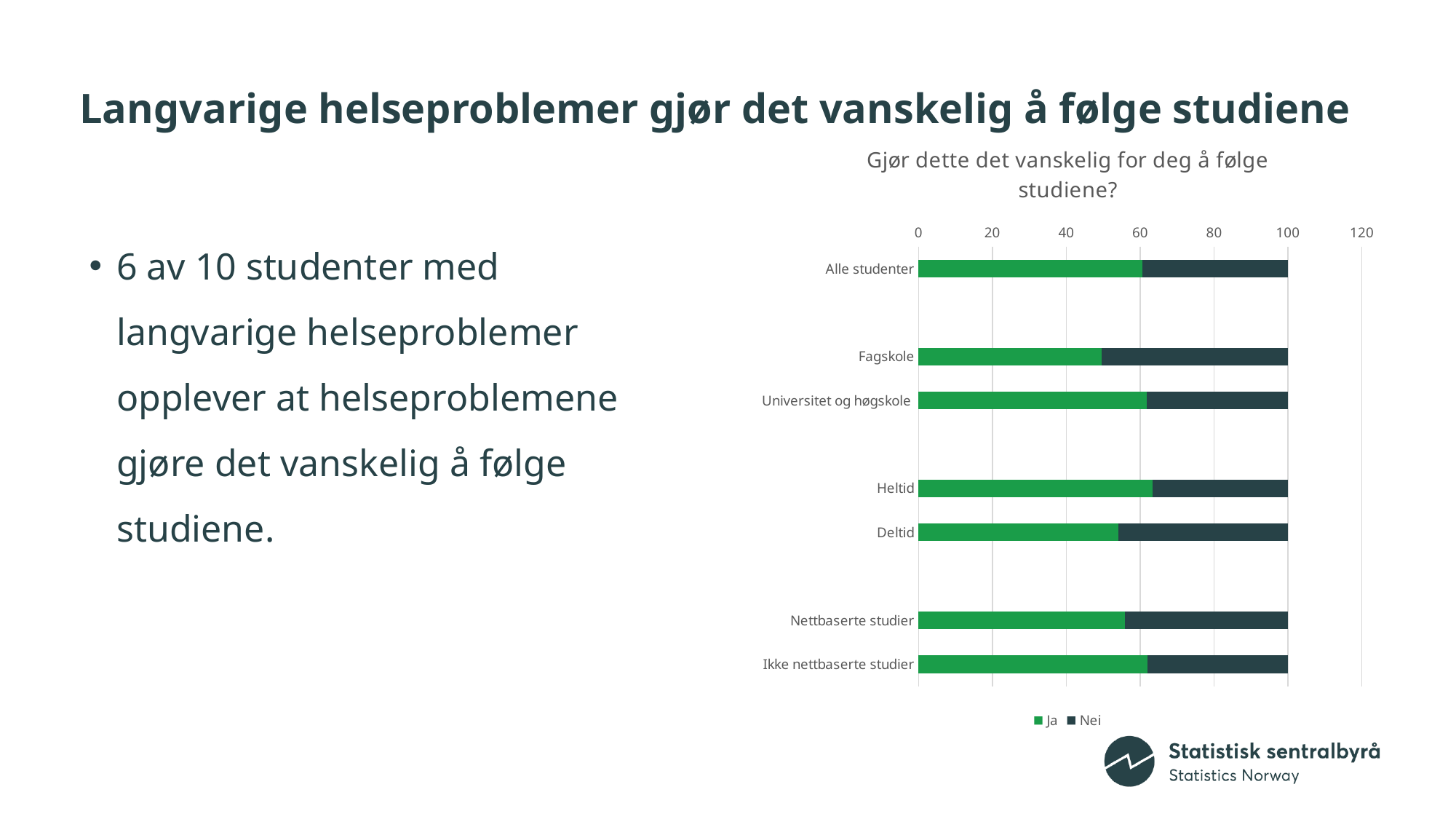
Is the Ja value for Fagskole greater or less than 60? less Which has the larger Ja value, Heltid or Deltid? Heltid What is the title of the chart? Gjør dette det vanskelig for deg å følge studiene? What are the two series named in the chart's legend? Ja and Nei How many series does the chart's legend list? 2 Is the Ja value for Nettbaserte studier greater or less than 60? less How many categories are shown on the chart's vertical axis? 7 What is the total of the stacked bar for Alle studenter? 100 Is the Ja value for Deltid greater or less than 40? greater Which has the larger Ja value, Fagskole or Universitet og høgskole? Universitet og høgskole What kind of chart is shown on the slide? Bar chart Which category has the lowest Ja value? Fagskole